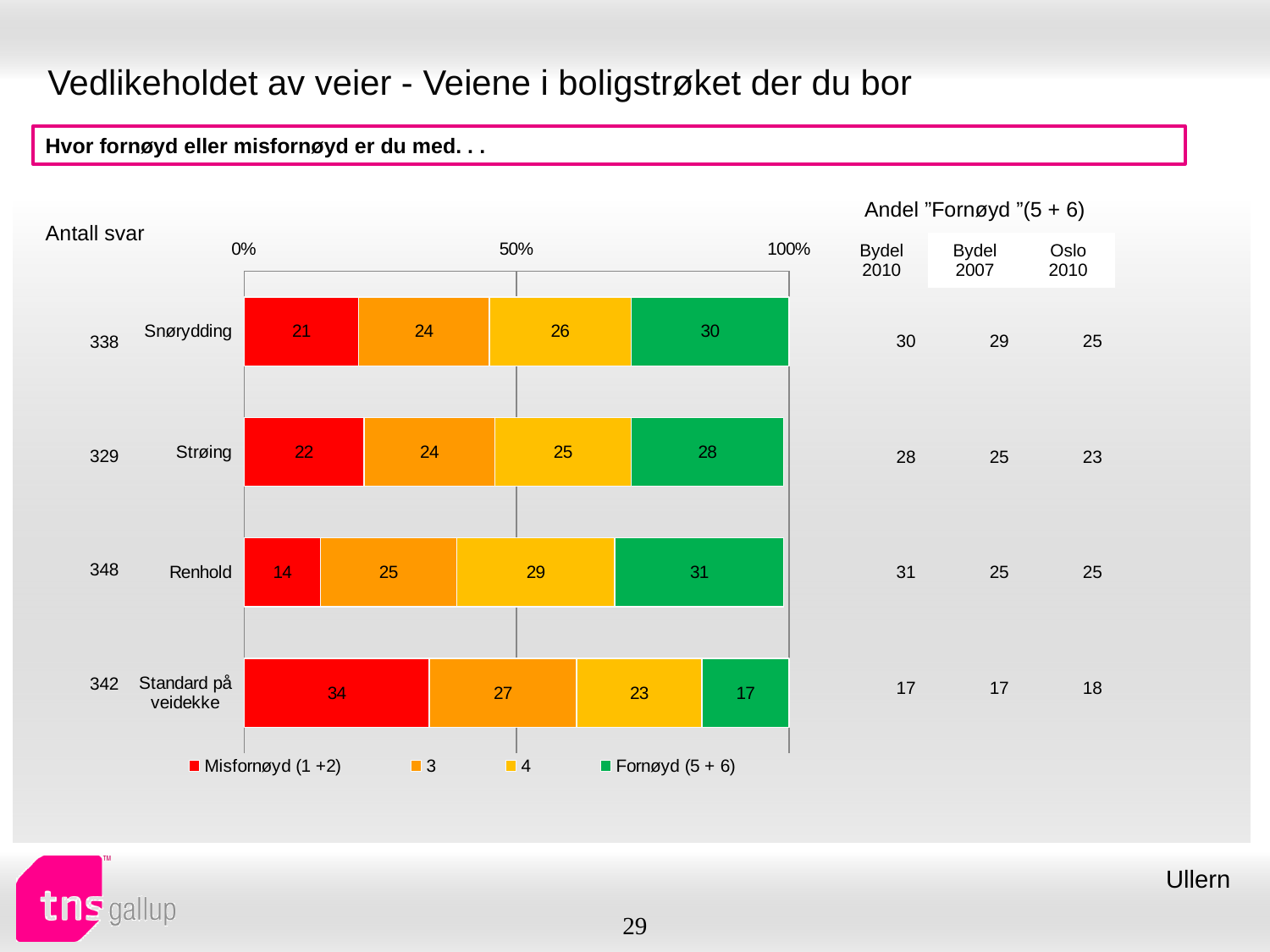
How many series does the legend list? 4 Which category has the lowest Misfornøyd (1 +2) value? Renhold Which legend entry is shown in red? Misfornøyd (1 +2) What is the value of the '4' segment for Renhold? 29 What kind of chart is shown on the slide? stacked bar chart What is the total of the stacked bar for Strøing? 99 Which category has the highest Fornøyd (5 + 6) value? Renhold What is the value of the Misfornøyd (1 +2) segment for Standard på veidekke? 34 What is the difference between the Misfornøyd (1 +2) values for Standard på veidekke and Renhold? 20 What is the value of the Fornøyd (5 + 6) segment for Snørydding? 30 How many categories are plotted in the chart? 4 Which is larger, the Fornøyd (5 + 6) value for Strøing or for Standard på veidekke? Strøing